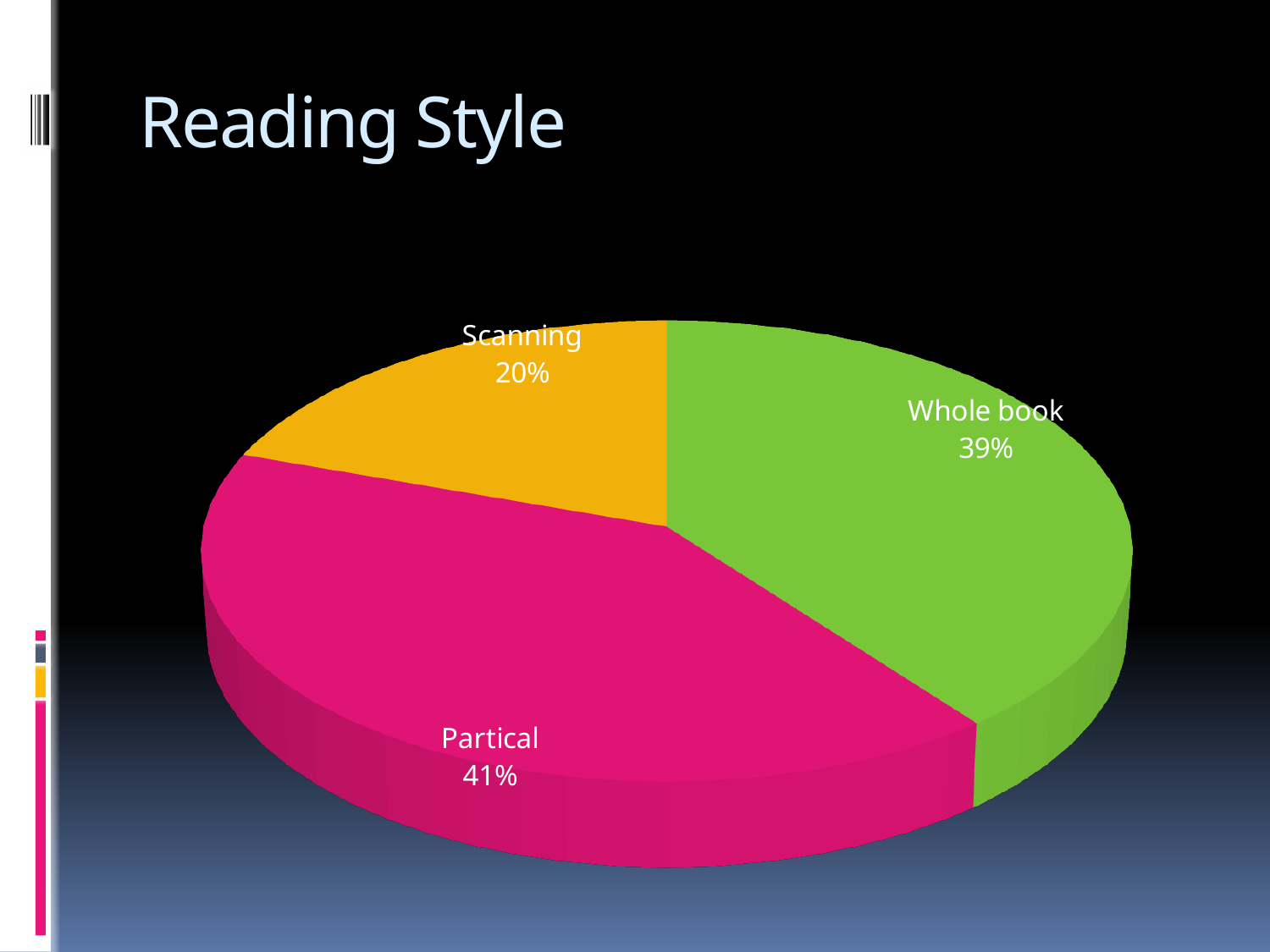
Which is larger, the share for Whole book or the share for Scanning? Whole book Which reading style has the largest share? Partical What is the title of the slide containing the chart? Reading Style What is the share for Partical? 41% What is the share for Scanning? 20% What is the difference in percentage points between Whole book and Scanning? 19 What colour is the Scanning slice? orange What is the share for Whole book? 39% How many slices does the pie chart have? 3 What is the difference in percentage points between Partical and Scanning? 21 What type of chart is shown on the slide? pie chart Which reading style has the smallest share? Scanning